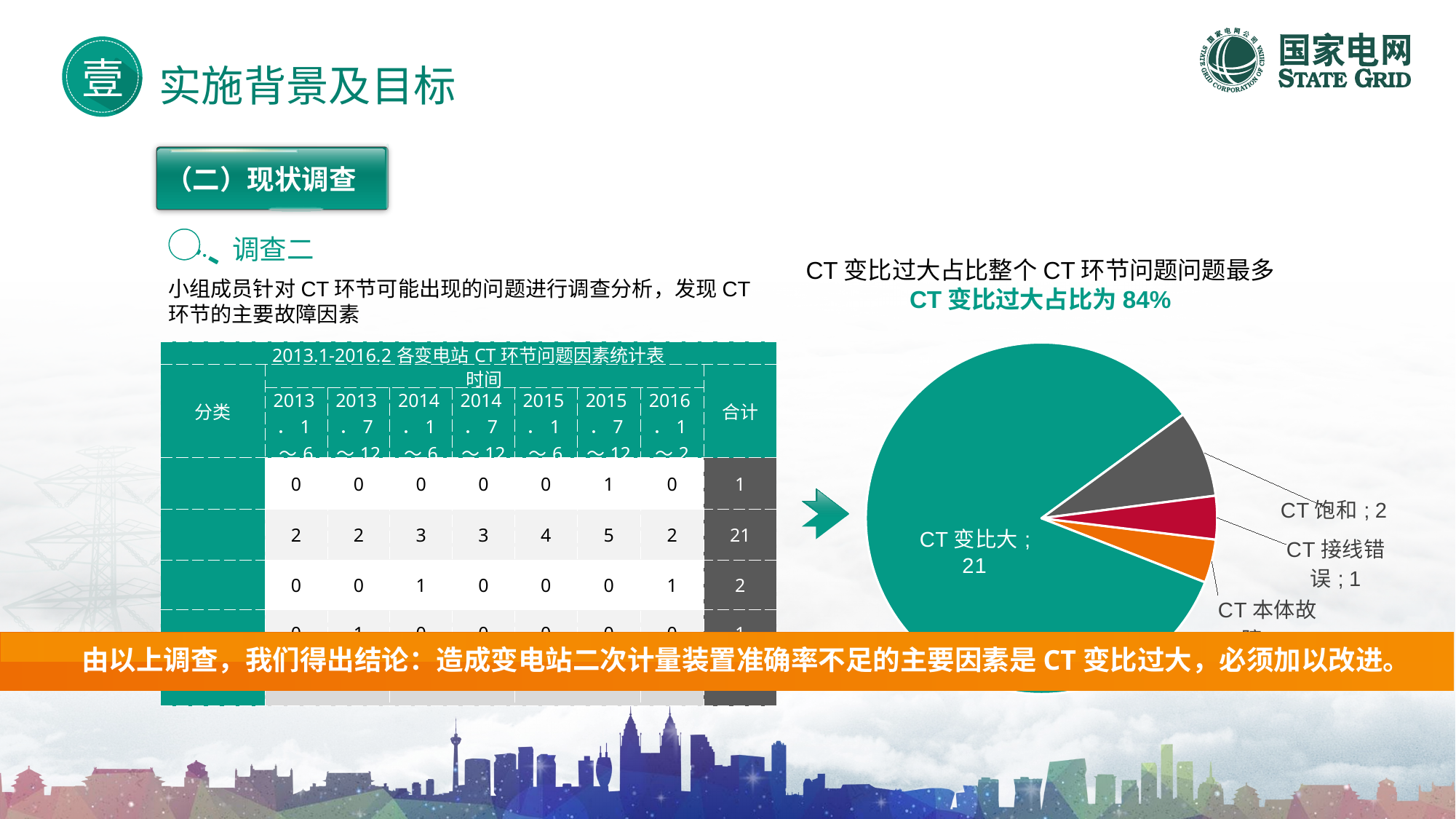
Which category has the largest slice in the pie chart? CT 变比大 What colour is the CT 变比大 slice in the pie chart? teal green In the pie chart, which is larger: CT 饱和 or CT 接线错误? CT 饱和 How many slices does the pie chart have? 4 What kind of chart is shown on the right of the slide? pie chart In the pie chart, what is the value for CT 变比大? 21 In the pie chart, what is the value for CT 饱和? 2 In the pie chart, what is the difference between the values for CT 饱和 and CT 接线错误? 1 In the pie chart, what is the difference between the values for CT 变比大 and CT 饱和? 19 In the pie chart, what is the value for CT 接线错误? 1 What colour is the CT 接线错误 slice in the pie chart? red According to the slide, what share of the pie does CT 变比过大 account for? 84%